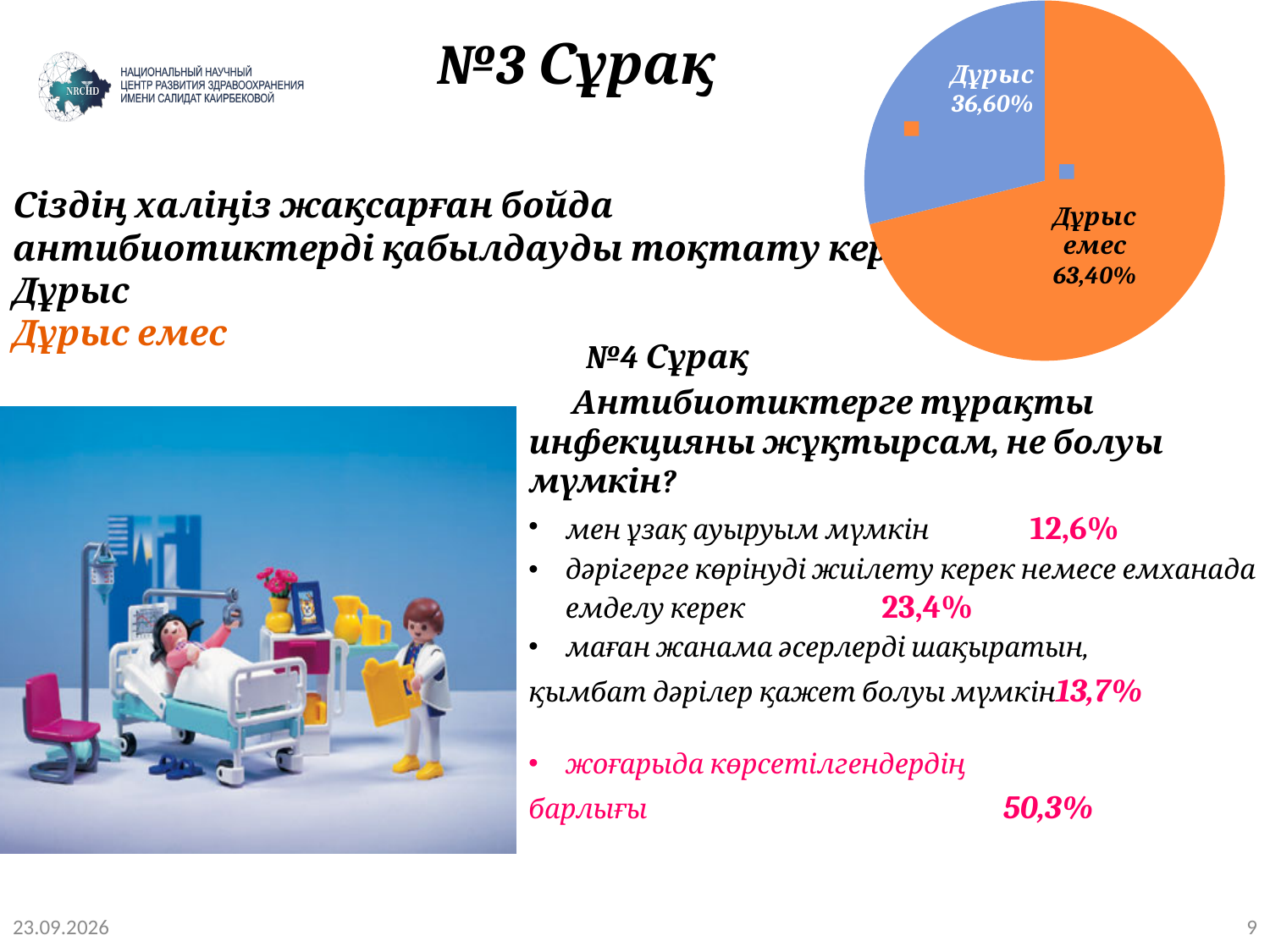
What is the difference between the "Дұрыс емес" and "Дұрыс" slices of the pie chart? 26,80% What share of the pie does the "Дұрыс емес" slice represent? 63,40% Which slice of the pie chart is the largest? Дұрыс емес What colour is the "Дұрыс" slice of the pie chart? blue How many slices does the pie chart have? 2 Which slice of the pie chart is the smallest? Дұрыс What is the value shown for the "Дұрыс емес" slice of the pie chart? 63,40% What colour is the "Дұрыс емес" slice of the pie chart? orange Which is larger in the pie chart, "Дұрыс" or "Дұрыс емес"? Дұрыс емес What is the value shown for the "Дұрыс" slice of the pie chart? 36,60% What kind of chart is shown on the slide? pie chart